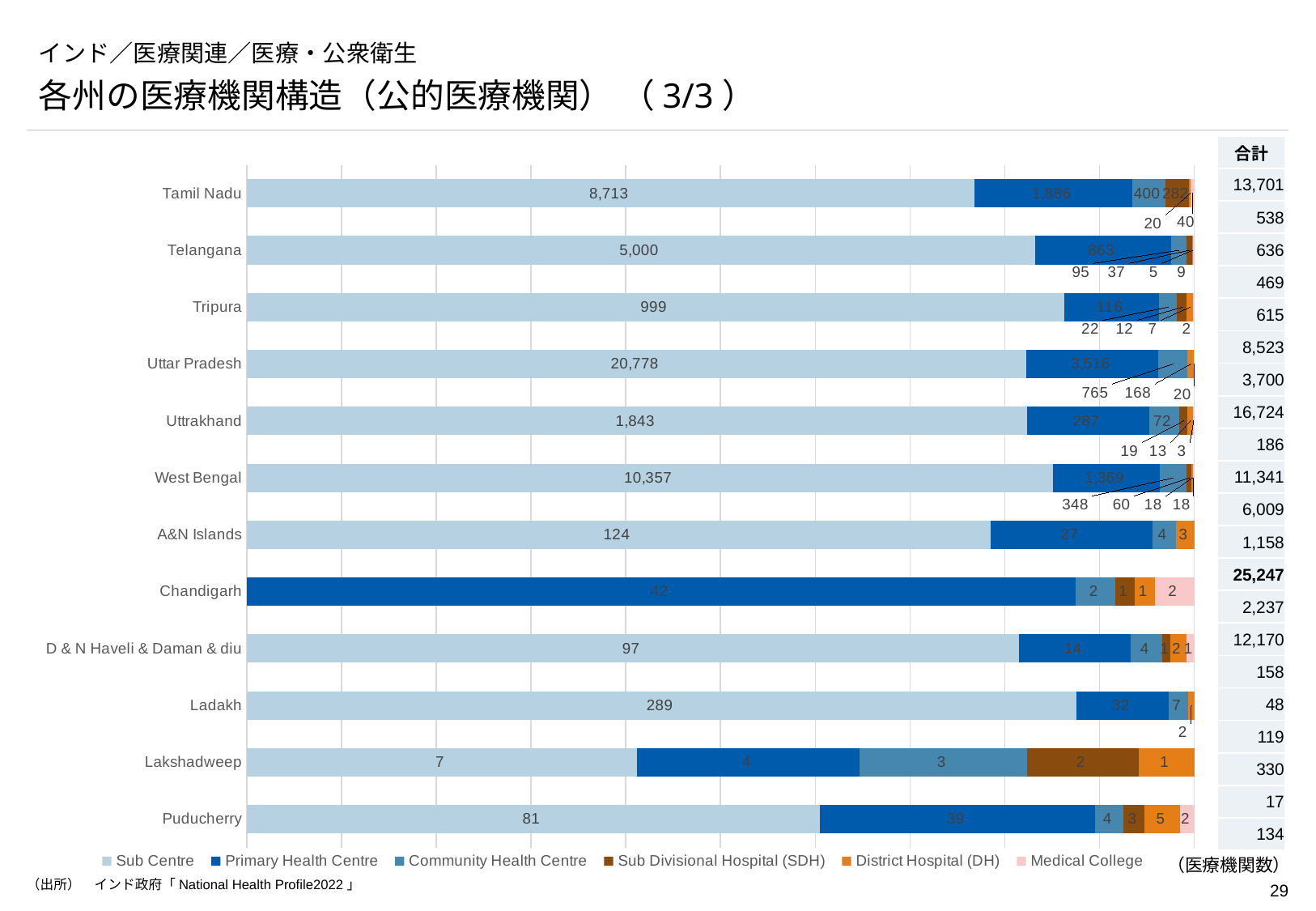
What is the Primary Health Centre value for Uttar Pradesh? 3,516 What is the total of all segments in the Lakshadweep bar? 17 How many states or territories are shown on the chart? 12 What is the District Hospital (DH) value for Puducherry? 5 What is the Medical College value for Chandigarh? 2 How many series does the legend list? 6 What is the difference between the Sub Centre values of West Bengal and Tamil Nadu? 1,644 What is the Community Health Centre value for West Bengal? 348 What is the Sub Centre value for Tamil Nadu? 8,713 Which has the larger Primary Health Centre value, Telangana or West Bengal? West Bengal Which state has the highest Sub Centre value? Uttar Pradesh What kind of chart is shown on the slide? Stacked bar chart